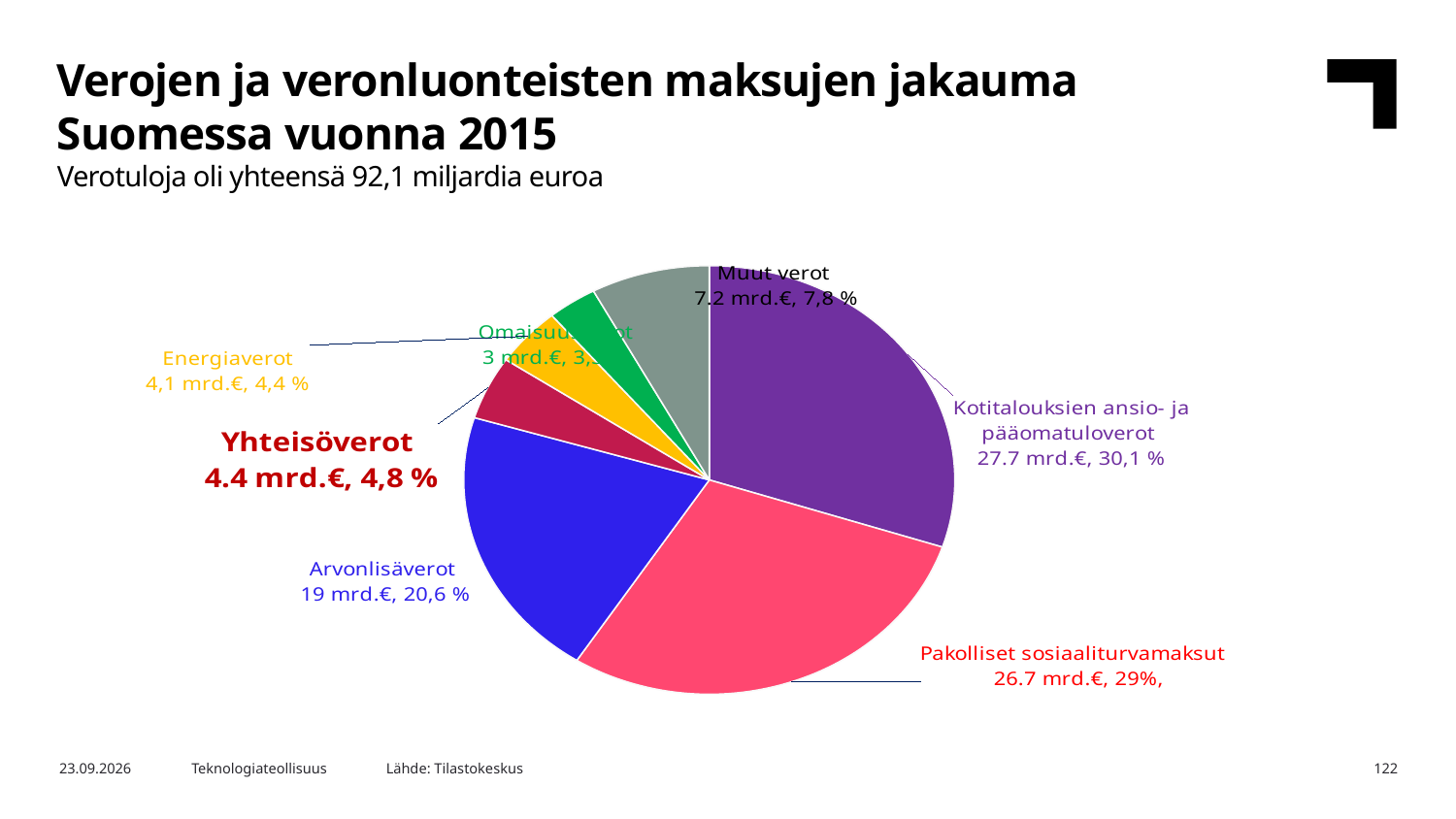
How many slices does the pie chart have? 7 What is the difference in mrd.€ between Arvonlisäverot and Muut verot? 11.8 mrd.€ What kind of chart is shown on the slide? pie chart What percentage share is shown for Kotitalouksien ansio- ja pääomatuloverot? 30,1 % What percentage share is shown for Energiaverot? 4,4 % What is the value shown for Yhteisöverot? 4.4 mrd.€ What is the value shown for Arvonlisäverot? 19 mrd.€ According to the subtitle, what was the total tax revenue? 92,1 miljardia euroa What percentage share is shown for Muut verot? 7,8 % Which category has the largest share of the pie? Kotitalouksien ansio- ja pääomatuloverot What is the value shown for Pakolliset sosiaaliturvamaksut? 26.7 mrd.€ Which is larger, Kotitalouksien ansio- ja pääomatuloverot or Pakolliset sosiaaliturvamaksut? Kotitalouksien ansio- ja pääomatuloverot